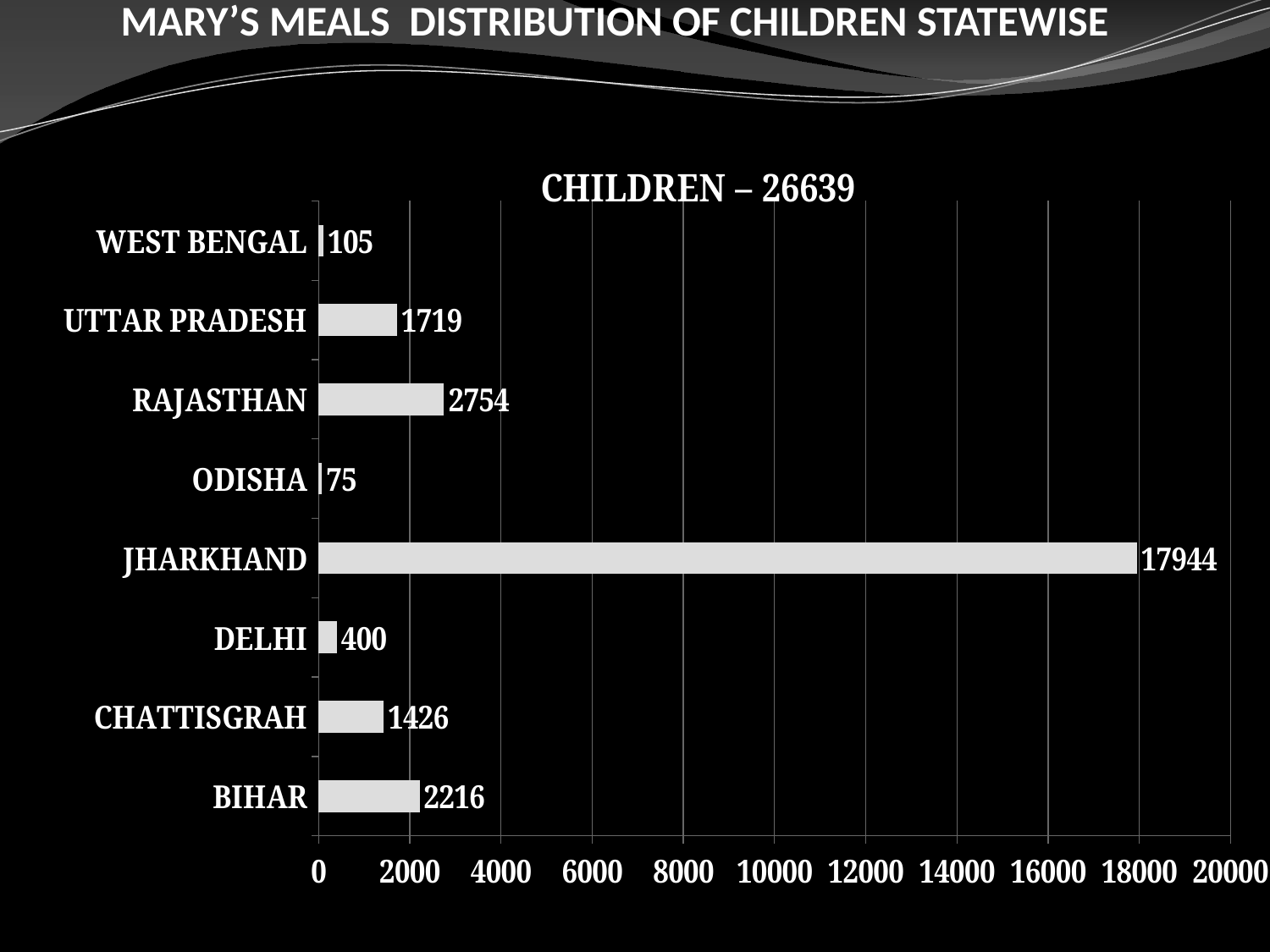
What is the title of the chart? CHILDREN – 26639 How many states are shown in the chart? 8 What is the difference between the values for RAJASTHAN and BIHAR? 538 Which state has the lowest value? ODISHA What is the value for JHARKHAND? 17944 What kind of chart is shown on the slide? bar chart What is the difference between the values for DELHI and WEST BENGAL? 295 Which state has the highest value? JHARKHAND Which is larger, the value for UTTAR PRADESH or the value for CHATTISGRAH? UTTAR PRADESH Is the value for JHARKHAND greater or less than 16000? greater What is the value for ODISHA? 75 What is the value for RAJASTHAN? 2754